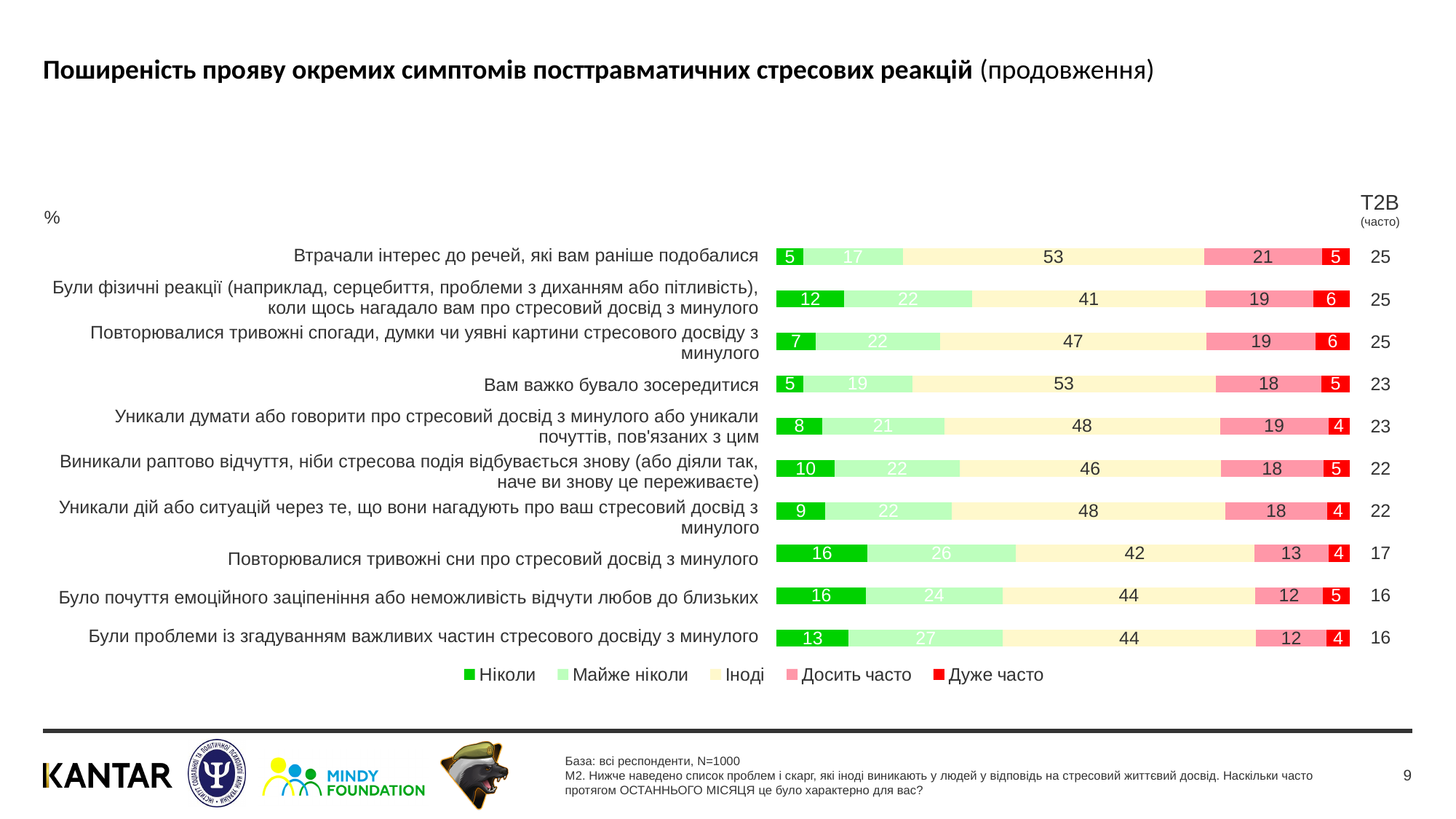
What is the value for "Ніколи" for "Повторювалися тривожні сни про стресовий досвід з минулого"? 16 How many series does the legend list? 5 What is the T2B (часто) value for "Були фізичні реакції (наприклад, серцебиття, проблеми з диханням або пітливість), коли щось нагадало вам про стресовий досвід з минулого"? 25 How many categories (symptoms) are shown in the chart? 10 What is the total of the stacked bar for "Були фізичні реакції (наприклад, серцебиття, проблеми з диханням або пітливість), коли щось нагадало вам про стресовий досвід з минулого"? 100 What is the difference between the "Іноді" values for "Втрачали інтерес до речей, які вам раніше подобалися" and "Повторювалися тривожні сни про стресовий досвід з минулого"? 11 What kind of chart is shown on the slide? Stacked horizontal bar chart What is the value for "Іноді" for "Вам важко бувало зосередитися"? 53 Which is larger: the "Ніколи" value for "Були фізичні реакції..." or for "Повторювалися тривожні спогади..."? Були фізичні реакції... Which category has the highest value for "Майже ніколи"? Були проблеми із згадуванням важливих частин стресового досвіду з минулого Which category has the highest value for "Досить часто"? Втрачали інтерес до речей, які вам раніше подобалися Which category has the lowest value for "Майже ніколи"? Втрачали інтерес до речей, які вам раніше подобалися